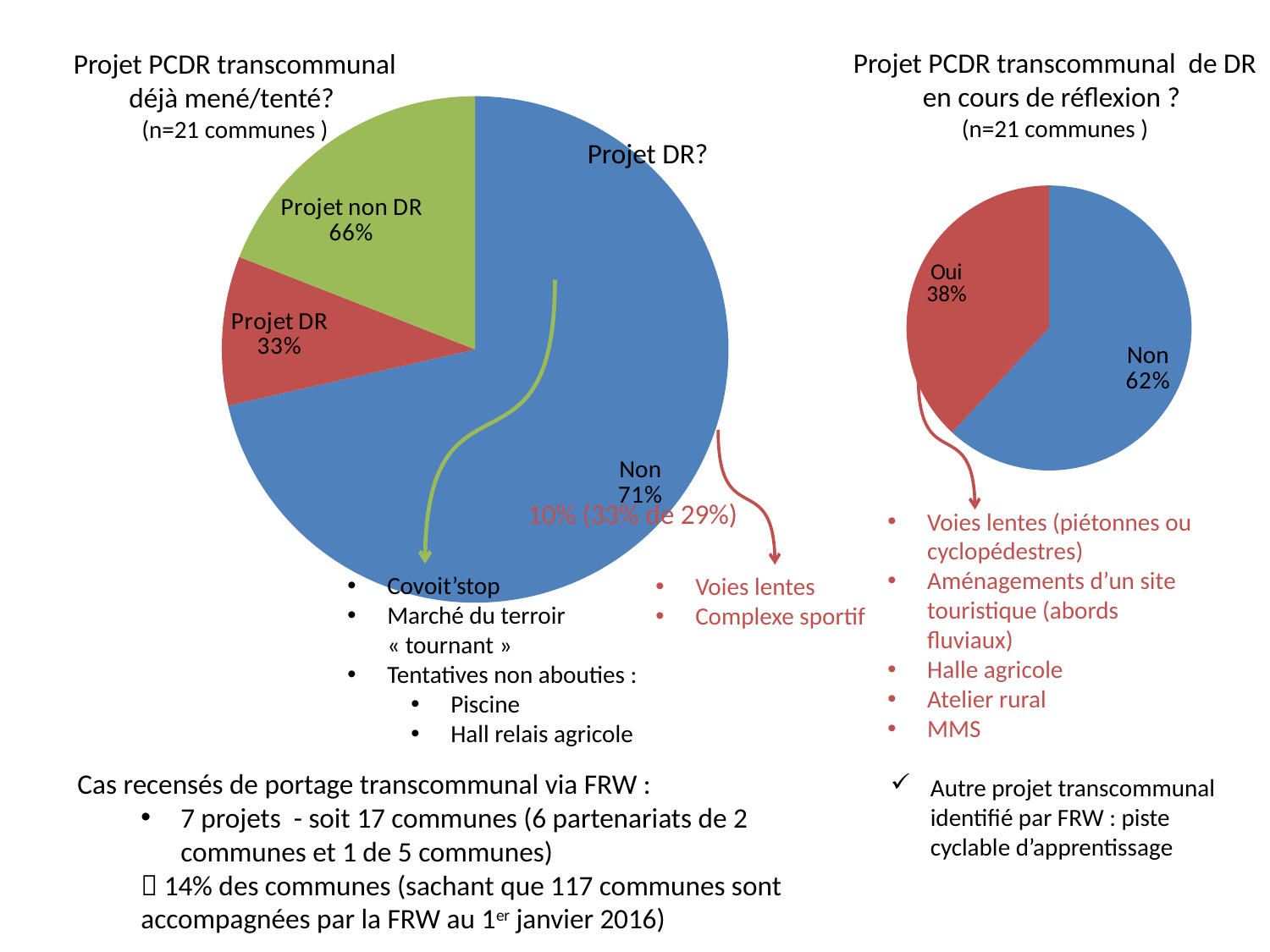
In the left chart 'Projet PCDR transcommunal déjà mené/tenté?', what percentage is shown for the 'Non' slice? 71% In the left chart 'Projet PCDR transcommunal déjà mené/tenté?', which labelled slice is the smallest? Projet DR In the right chart 'Projet PCDR transcommunal de DR en cours de réflexion ?', what percentage is shown for 'Oui'? 38% In the left chart 'Projet PCDR transcommunal déjà mené/tenté?', which labelled slice has the largest share of the pie? Non In the left chart 'Projet PCDR transcommunal déjà mené/tenté?', what percentage is shown for 'Projet non DR'? 66% In the left chart 'Projet PCDR transcommunal déjà mené/tenté?', what percentage is shown for 'Projet DR'? 33% According to the subtitle of the right chart 'Projet PCDR transcommunal de DR en cours de réflexion ?', how many communes are in the sample? n=21 communes What type of chart is used for 'Projet PCDR transcommunal de DR en cours de réflexion ?'? Pie chart In the right chart 'Projet PCDR transcommunal de DR en cours de réflexion ?', which slice is larger, 'Oui' or 'Non'? Non In the right chart 'Projet PCDR transcommunal de DR en cours de réflexion ?', what is the difference in percentage points between 'Non' and 'Oui'? 24 percentage points In the right chart 'Projet PCDR transcommunal de DR en cours de réflexion ?', what percentage is shown for 'Non'? 62% How many slices does the left chart 'Projet PCDR transcommunal déjà mené/tenté?' have? 3